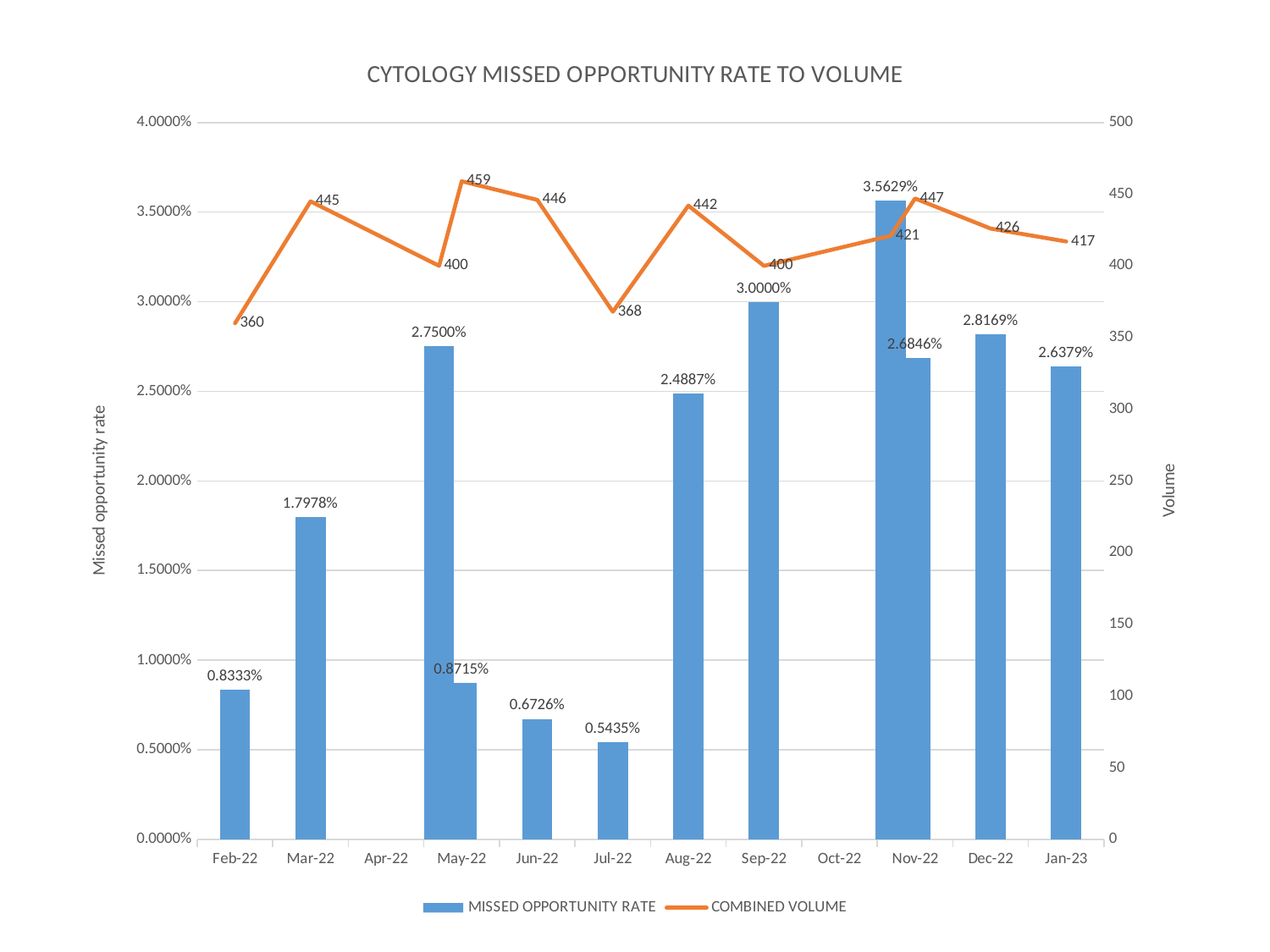
What is the title of the right-hand vertical axis? Volume What is the missed opportunity rate for Feb-22? 0.8333% How many series does the legend list? 2 Which month has the lowest missed opportunity rate? Jul-22 What is the highest combined volume value shown on the line? 459 What is the difference between the missed opportunity rates for Dec-22 and Jan-23? 0.1790% What is the combined volume for Feb-22? 360 Which has the higher missed opportunity rate, Aug-22 or Sep-22? Sep-22 What is the missed opportunity rate for Jul-22? 0.5435% What kind of chart is shown on the slide? A combination bar and line chart What is the combined volume for Jan-23? 417 What is the missed opportunity rate for Sep-22? 3.0000%